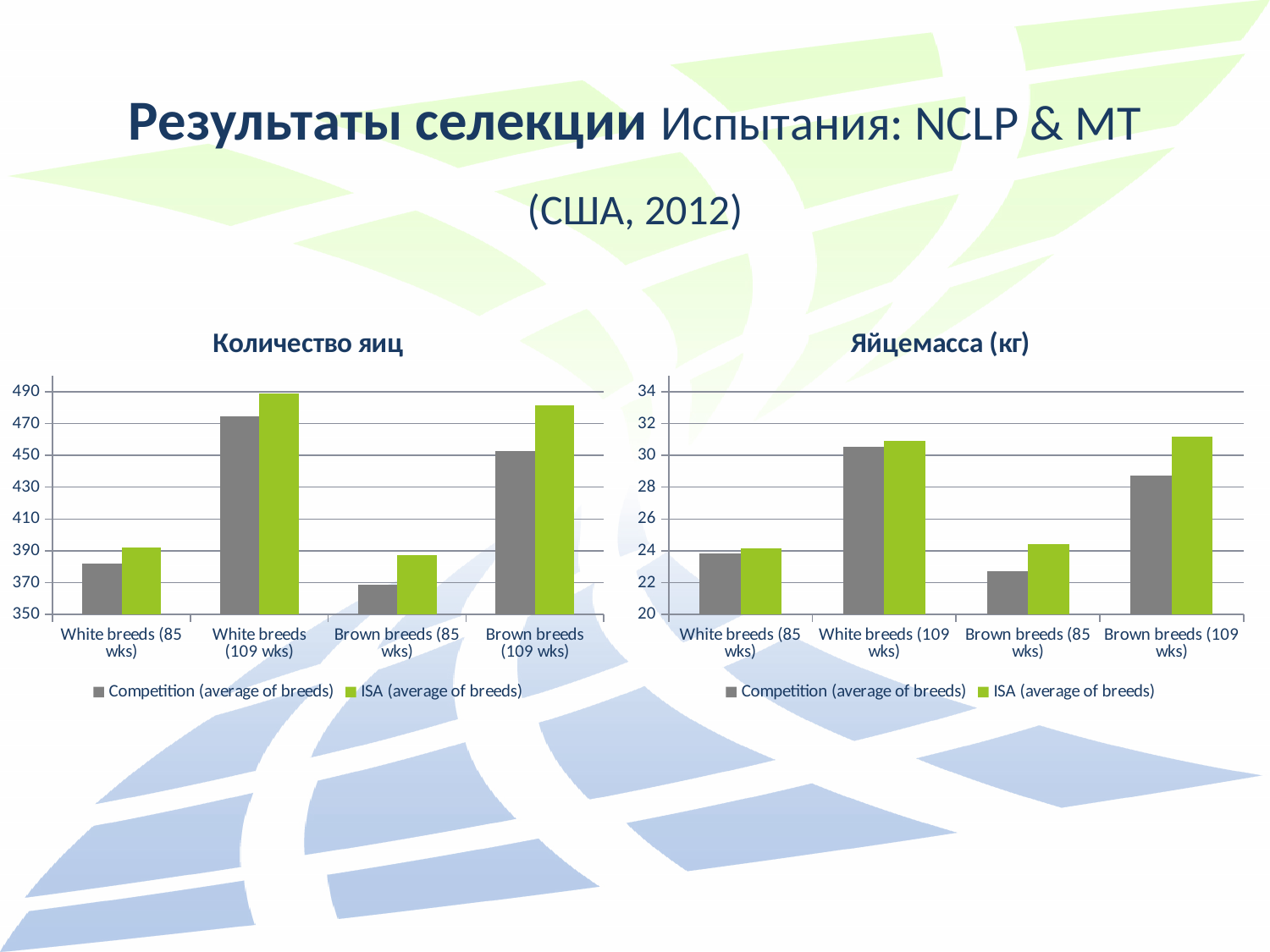
In the 'Количество яиц' chart, which category has the lowest value for Competition (average of breeds)? Brown breeds (85 wks) In the 'Яйцемасса (кг)' chart, which category has the lowest value for Competition (average of breeds)? Brown breeds (85 wks) In the 'Количество яиц' chart, is the value for Competition (average of breeds) at White breeds (85 wks) greater or less than 390? less In the 'Яйцемасса (кг)' chart, is the value for ISA (average of breeds) at Brown breeds (109 wks) greater or less than 30? greater In the 'Количество яиц' chart, is the value for ISA (average of breeds) at White breeds (109 wks) greater or less than 470? greater In the 'Количество яиц' chart, for Brown breeds (109 wks), which series has the larger value: Competition (average of breeds) or ISA (average of breeds)? ISA (average of breeds) In the 'Яйцемасса (кг)' chart, which category has the highest value for Competition (average of breeds)? White breeds (109 wks) How many series does the legend of the 'Количество яиц' chart list? 2 What type of chart is the 'Количество яиц' chart? bar chart In the 'Количество яиц' chart, which category has the highest value for ISA (average of breeds)? White breeds (109 wks) In the 'Яйцемасса (кг)' chart, what colour represents ISA (average of breeds)? green How many categories are shown on the x axis of the 'Яйцемасса (кг)' chart? 4